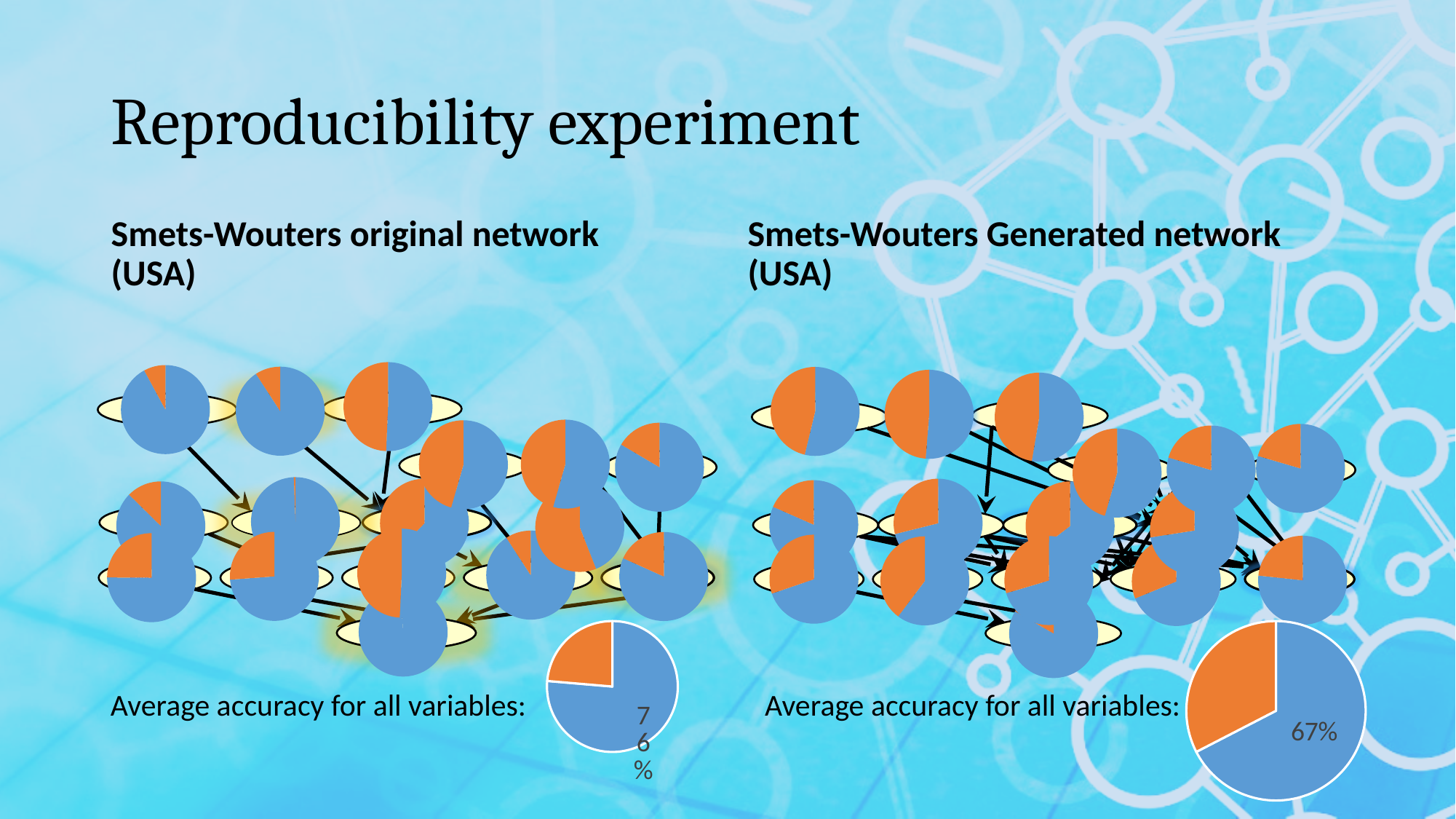
On the right pie chart (Smets-Wouters Generated network), what is the average accuracy for all variables shown as the data label? 67% Which network has the higher average accuracy for all variables, the original network or the Generated network? Original network Which pie chart has the larger orange slice, the one for the original network or the one for the Generated network? Generated network What is the title of the slide containing the two accuracy pie charts? Reproducibility experiment On the right pie chart (Generated network), is the blue slice's share greater or less than 50%? greater On the left pie chart (Smets-Wouters original network), what is the average accuracy for all variables shown as the data label? 76% On the right pie chart (Generated network), how many slices does the pie have? 2 On the left pie chart (original network), what colour is the slice labelled 76%? Blue What kind of chart is used to show the average accuracy for all variables on each side of the slide? Pie chart On the left pie chart (original network), how many slices does the pie have? 2 On the left pie chart (original network), is the orange slice's share greater or less than 50%? less What is the difference in percentage points between the average accuracy of the original network (76%) and the Generated network (67%)? 9